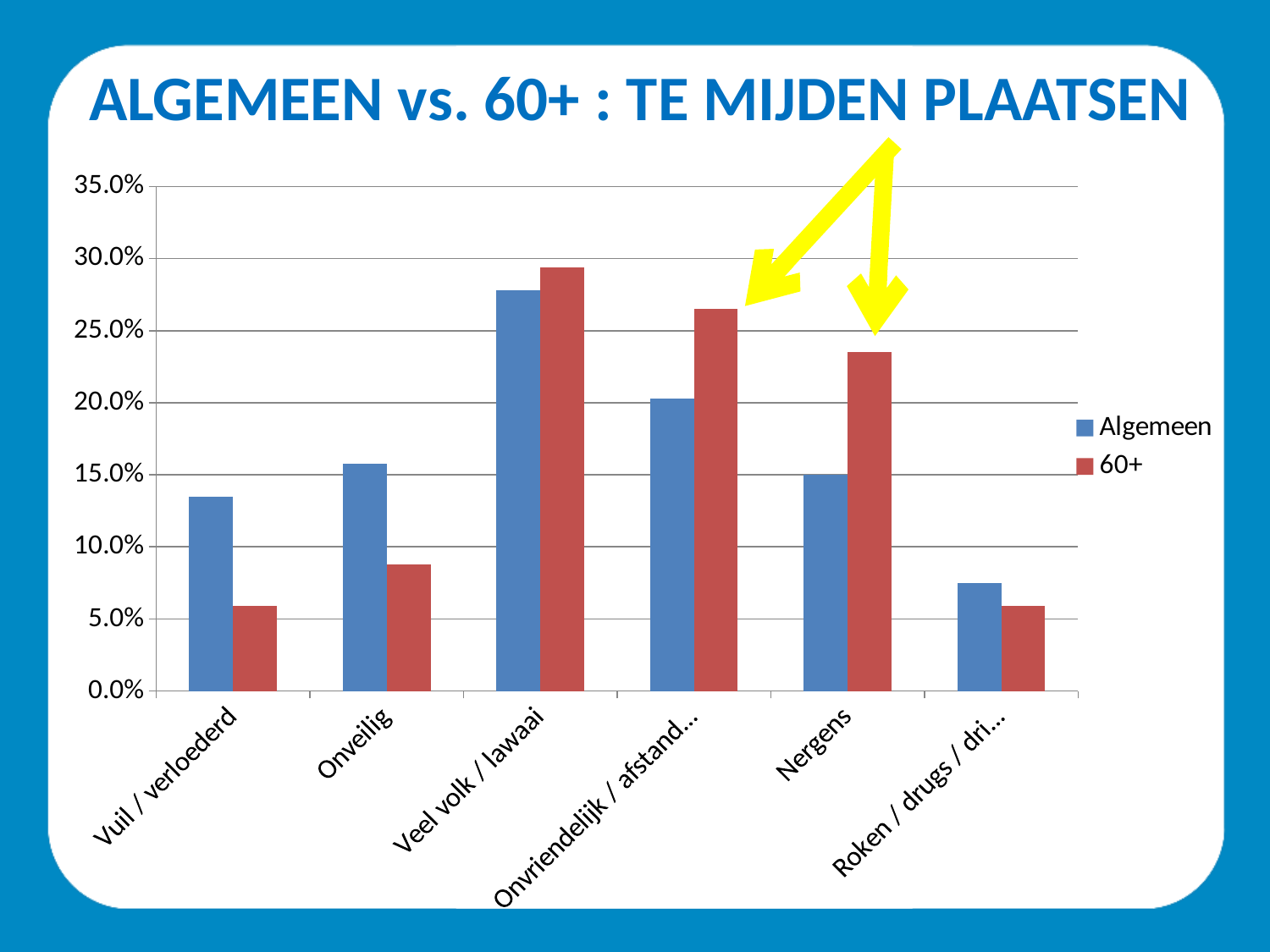
Is the Algemeen value for Vuil / verloederd greater or less than 10.0%? greater Is the 60+ value for Onveilig greater or less than 10.0%? less For Vuil / verloederd, which series has the larger value, Algemeen or 60+? Algemeen How many categories are shown on the x axis? 6 Which category has the highest value for the 60+ series? Veel volk / lawaai For Nergens, which series has the larger value, Algemeen or 60+? 60+ Is the 60+ value for Nergens greater or less than 20.0%? greater For Onveilig, which series has the larger value, Algemeen or 60+? Algemeen What is the title of the chart on the slide? ALGEMEEN vs. 60+ : TE MIJDEN PLAATSEN How many series does the legend list? 2 Which category has the highest value for the Algemeen series? Veel volk / lawaai What kind of chart is shown on the slide? bar chart